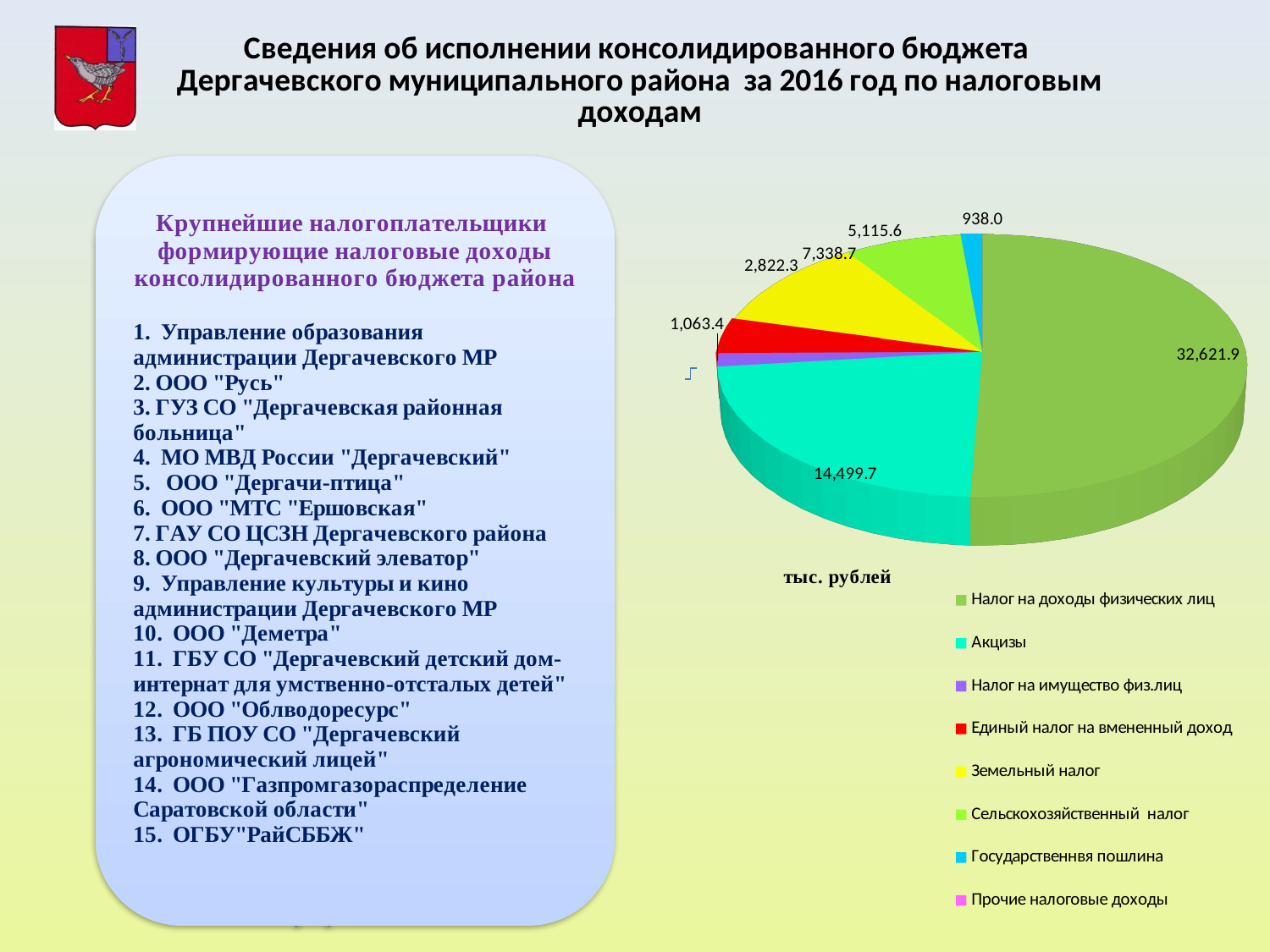
What is the value for Государственная пошлина? 938.0 What is the value for Сельскохозяйственный налог? 5,115.6 Which category has the largest slice of the pie? Налог на доходы физических лиц In what units are the chart values given? тыс. рублей What type of chart is shown on the slide? pie chart How many entries does the chart legend list? 8 What is the value for Акцизы? 14,499.7 What is the value for Единый налог на вмененный доход? 2,822.3 Which is larger: Земельный налог or Сельскохозяйственный налог? Земельный налог What is the difference between the values for Налог на доходы физических лиц and Акцизы? 18,122.2 What is the value for Земельный налог? 7,338.7 What is the value for Налог на доходы физических лиц? 32,621.9